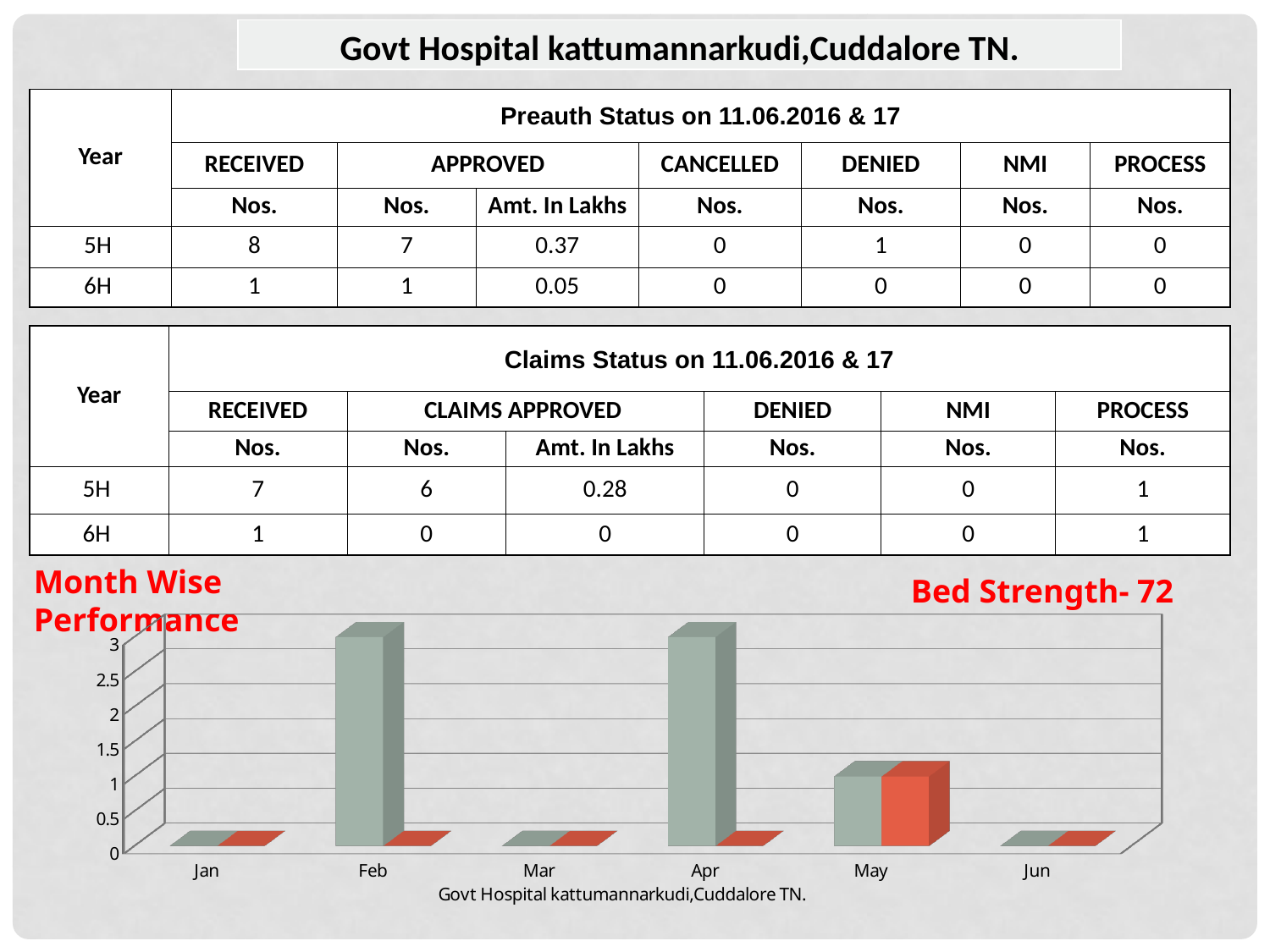
What is the value of the grey bar for Feb in the chart? 3 What is the difference between the grey bar for Feb and the grey bar for May in the chart? 2 Which months have the tallest grey bars in the chart? Feb and Apr How many months are shown on the x axis of the chart? 6 What is the value of the grey bar for May in the chart? 1 What is the value of the red bar for May in the chart? 1 Which is larger in the chart, the grey bar for Feb or the grey bar for May? Feb What is the value of the grey bar for Apr in the chart? 3 Is the grey bar for Apr in the chart greater or less than 2? greater What kind of chart is shown at the bottom of the slide? bar chart Which is the only month in the chart where the red bar is above zero? May What text appears below the x axis of the chart? Govt Hospital kattumannarkudi,Cuddalore TN.